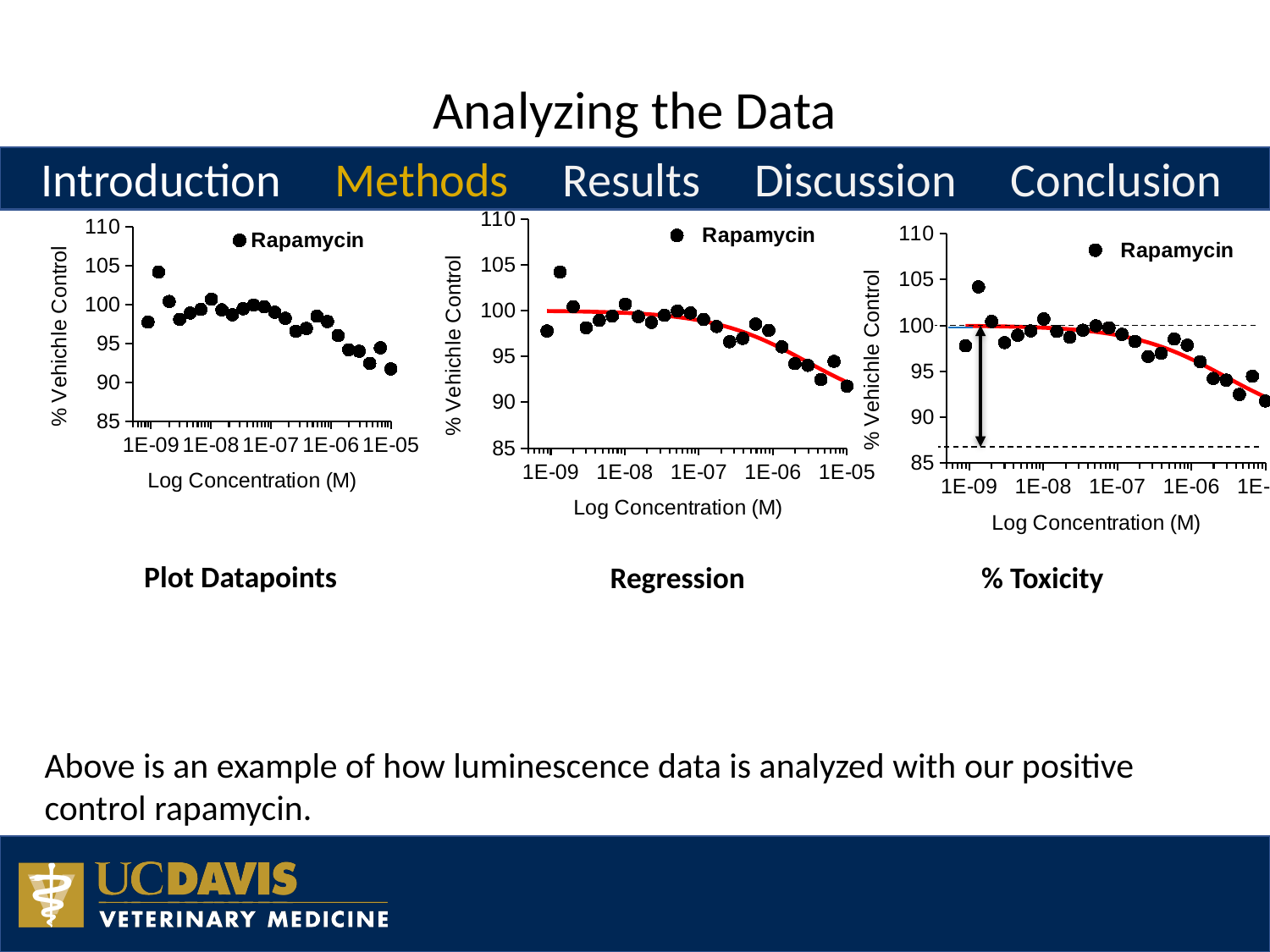
In the 'Plot Datapoints' chart, do the values overall rise or fall as the concentration increases along the x axis? fall What is the name of the series shown in the legend of the '% Toxicity' chart? Rapamycin In the 'Plot Datapoints' chart, is the highest data point greater or less than 100? greater In the '% Toxicity' chart, is the lowest data point greater or less than 95? less In the 'Regression' chart, is the value of the leftmost data point greater or less than 95? greater In the 'Regression' chart, does the fitted red line rise or fall as concentration increases along the x axis? fall What is the x-axis label of the 'Plot Datapoints' chart? Log Concentration (M) What kind of chart is the 'Plot Datapoints' chart on the left? scatter chart How many series does the legend of the 'Regression' chart list? 1